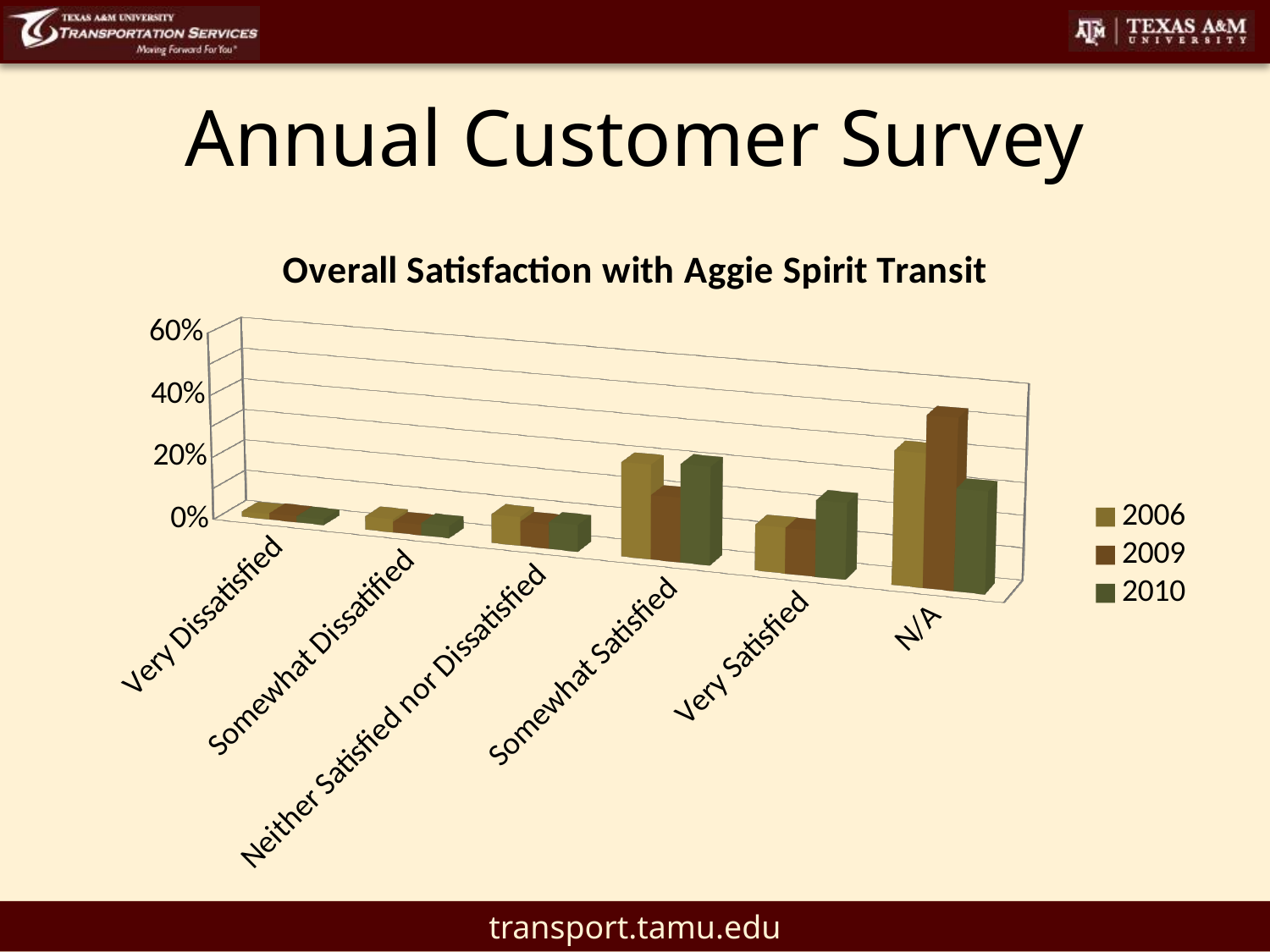
What is the title of the chart? Overall Satisfaction with Aggie Spirit Transit For the N/A category, which is larger: the 2009 value or the 2010 value? 2009 For Somewhat Satisfied, which is larger: the 2006 value or the 2009 value? 2006 Which category has the tallest bar overall in the chart? N/A How many response categories are shown on the x axis? 6 How many series does the legend list? 3 Is the 2009 value for N/A greater or less than 20%? greater What kind of chart is shown on the slide? bar chart For Very Satisfied, which is larger: the 2006 value or the 2010 value? 2010 Is the 2006 value for Very Dissatisfied greater or less than 20%? less Which category has the highest value for 2009? N/A Which years are listed in the legend? 2006, 2009, 2010